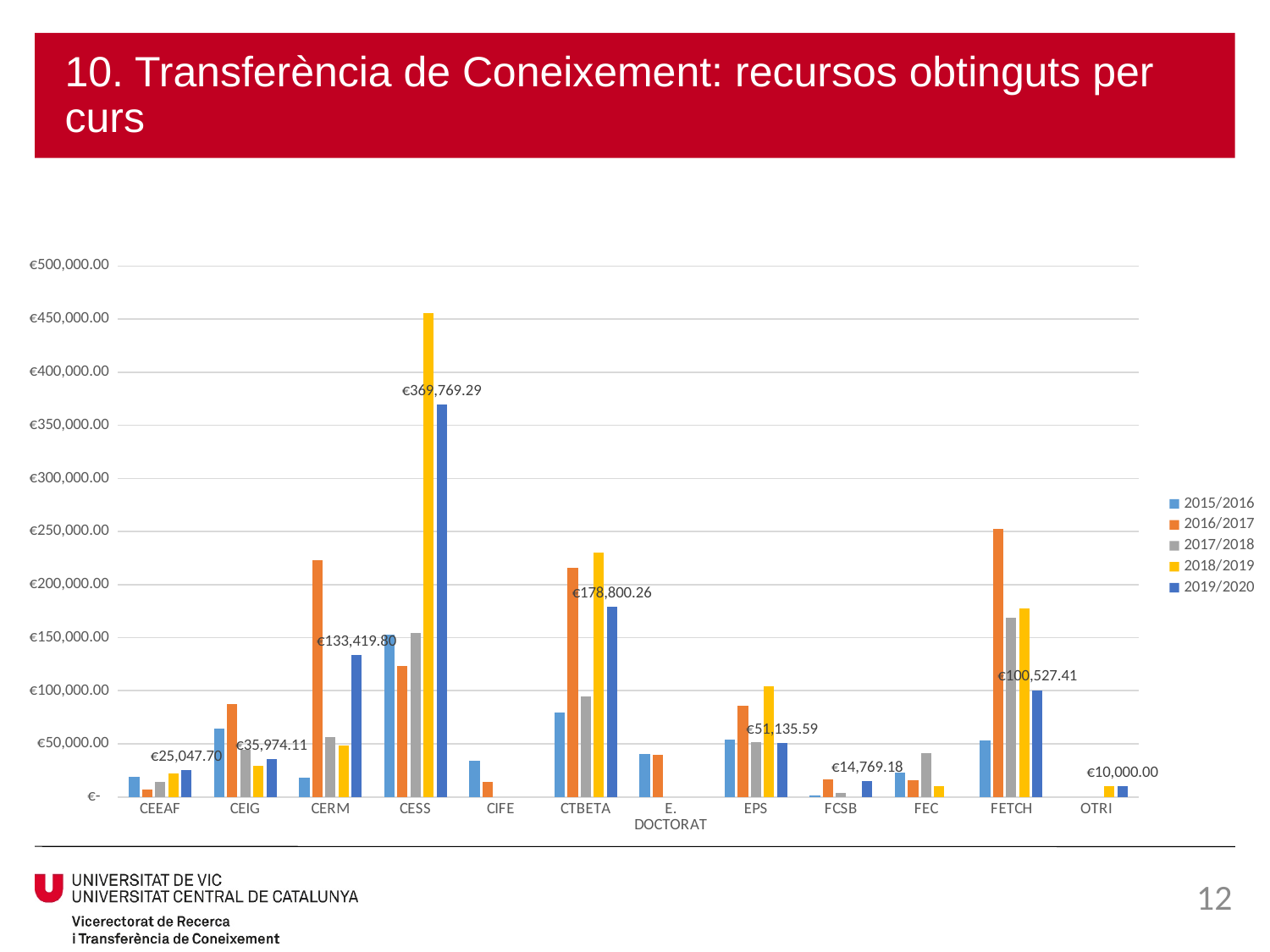
Among the categories with a labelled 2019/2020 value, which has the lowest? OTRI Which category has the highest 2019/2020 value? CESS How many categories are shown on the x axis? 12 How many series does the legend list? 5 Which is larger, the 2019/2020 value for CERM or for CTBETA? CTBETA What is the 2019/2020 value for CESS? €369,769.29 Is the 2018/2019 value for CESS greater or less than €400,000.00? greater What is the 2019/2020 value for OTRI? €10,000.00 What kind of chart is shown on the slide? bar chart What is the difference between the 2019/2020 values for CTBETA and FETCH? €78,272.85 What is the 2019/2020 value for FETCH? €100,527.41 Is the 2016/2017 value for FETCH greater or less than €200,000.00? greater